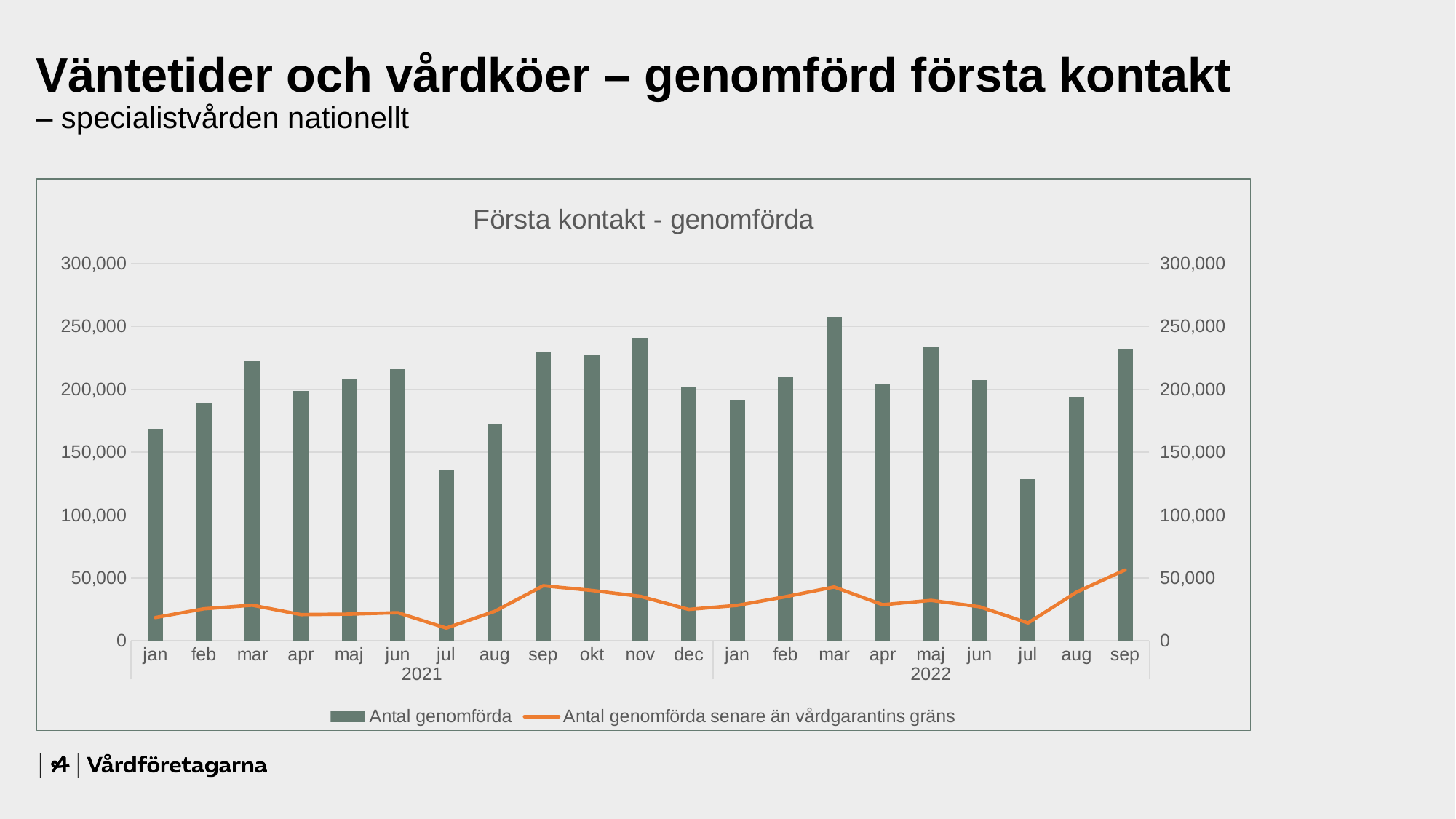
What is the title of the chart? Första kontakt - genomförda Which month in 2021 has the lowest number of 'Antal genomförda'? jul 2021 How many series does the legend list? 2 Which month has the highest number of 'Antal genomförda'? mar 2022 In which month does the line 'Antal genomförda senare än vårdgarantins gräns' reach its highest value? sep 2022 Which is larger, 'Antal genomförda' for mar 2021 or for mar 2022? mar 2022 Do the 'Antal genomförda' bars rise or fall from jan 2021 to mar 2021? rise How many months (bars) are plotted in the chart? 21 What kind of chart is shown on the slide? A bar chart combined with a line Is the value of 'Antal genomförda' for nov 2021 greater or less than 200,000? greater Is the value of 'Antal genomförda' for mar 2022 greater or less than 250,000? greater Is the value of 'Antal genomförda' for jul 2021 greater or less than 150,000? less